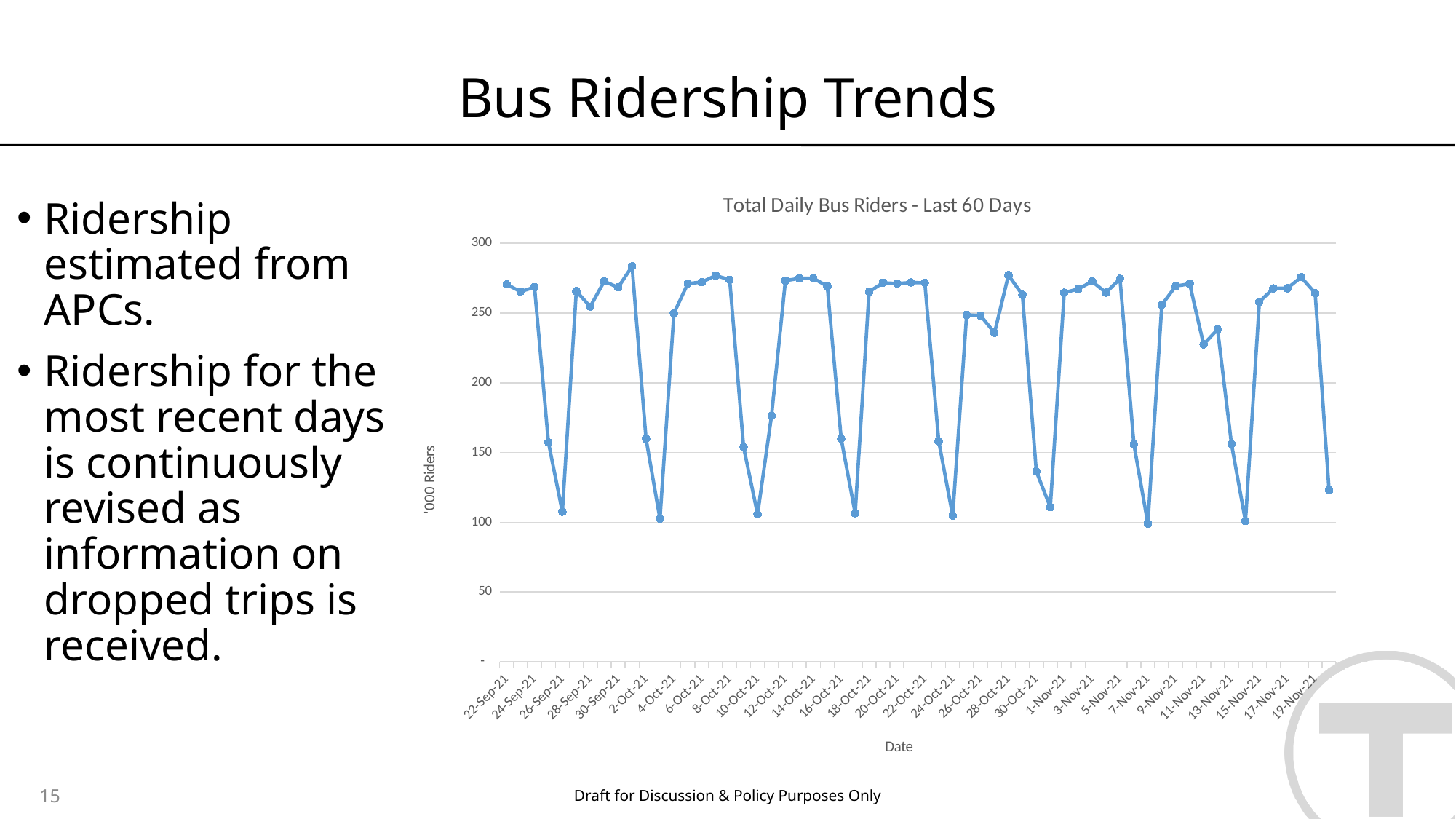
What kind of chart is shown on the slide? line chart Is the value for 22-Sep-21 greater or less than 250? greater Is the value for 24-Oct-21 greater or less than 150? less Is the value for 11-Nov-21 greater or less than 200? greater What is the title of the chart? Total Daily Bus Riders - Last 60 Days What is the label on the vertical axis of the chart? '000 Riders